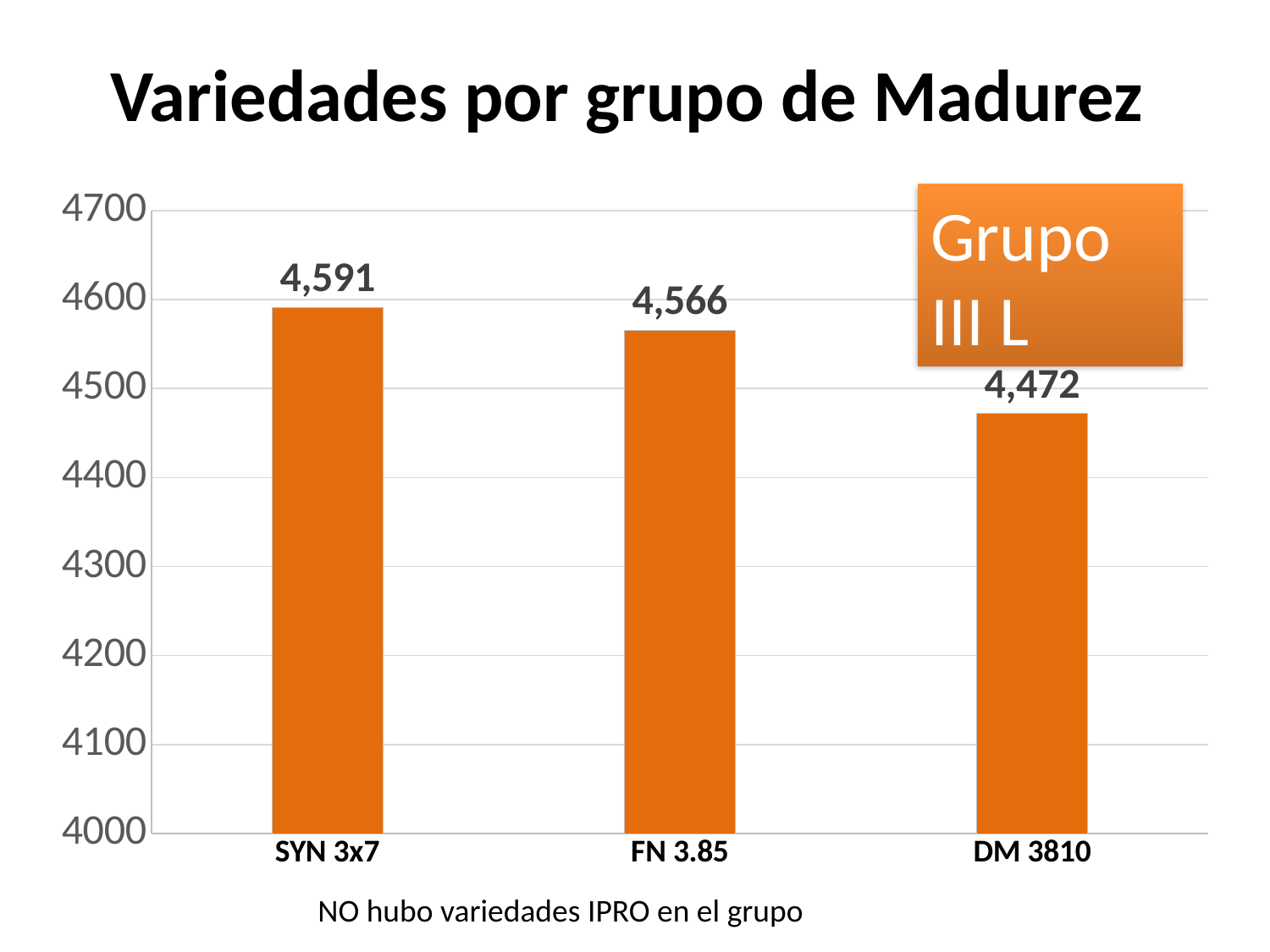
What is the difference between the values for SYN 3x7 and DM 3810? 119 How many varieties are shown in the chart? 3 What is the difference between the values for FN 3.85 and DM 3810? 94 What is the value for DM 3810? 4,472 Which variety has the highest value? SYN 3x7 Do the values rise or fall from left to right across the varieties? fall What is the value for FN 3.85? 4,566 What kind of chart is shown on the slide? bar chart What is the value for SYN 3x7? 4,591 Is the value for DM 3810 greater or less than 4500? less Which is larger, the value for FN 3.85 or the value for DM 3810? FN 3.85 Which variety has the lowest value? DM 3810